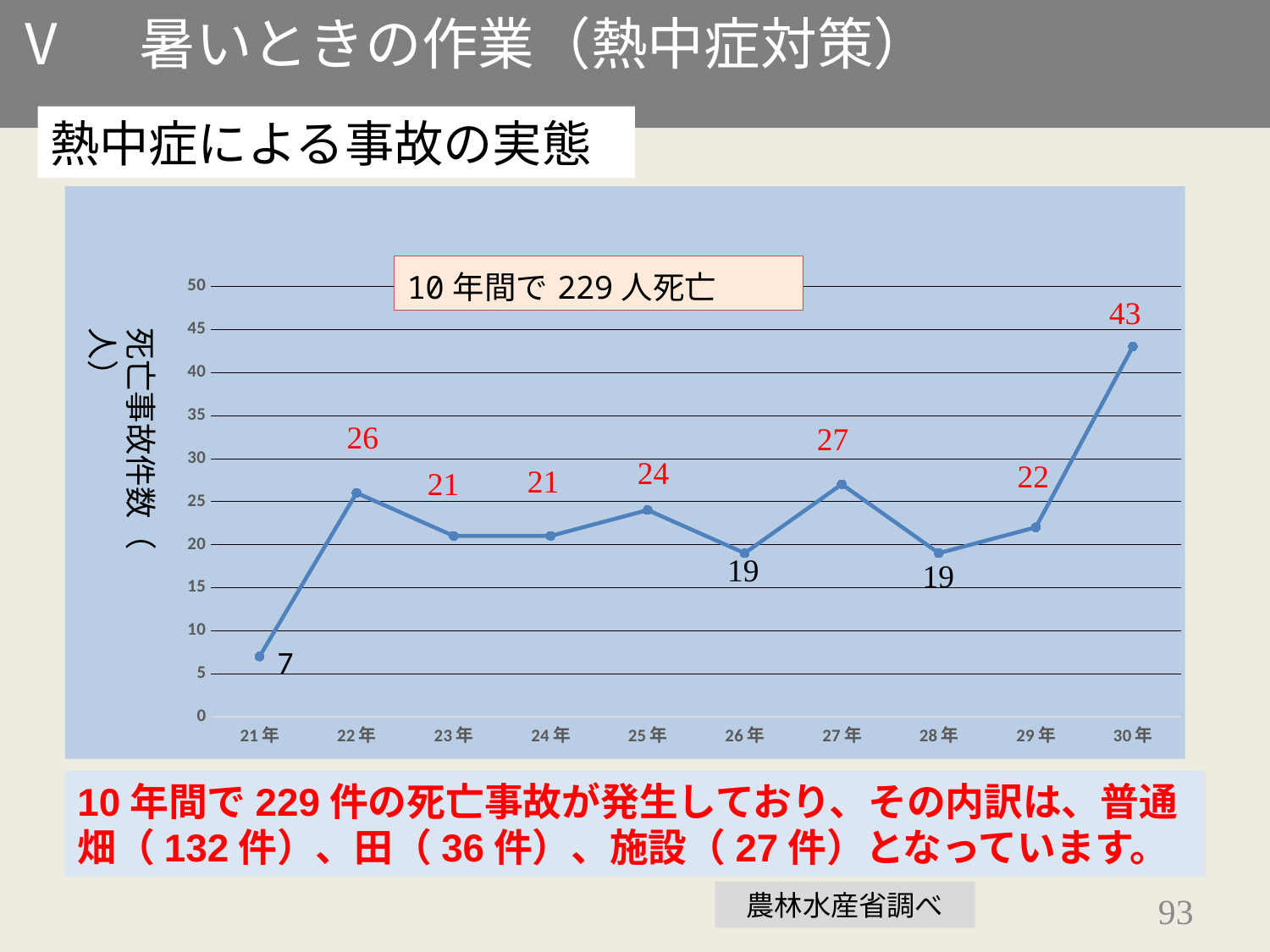
What is the value for 27年? 27 What is the difference between the values for 30年 and 29年? 21 How many data points (years) are plotted on the chart? 10 Is the value for 30年 greater or less than 40? greater Which is larger, the value for 22年 or the value for 25年? 22年 Which year has the highest value? 30年 What is the difference between the values for 22年 and 21年? 19 Which year has the lowest value? 21年 What is the value for 30年? 43 What is the value for 21年? 7 What total number of deaths over 10 years is stated in the box on the chart? 229人 What type of chart is shown on the slide? line chart